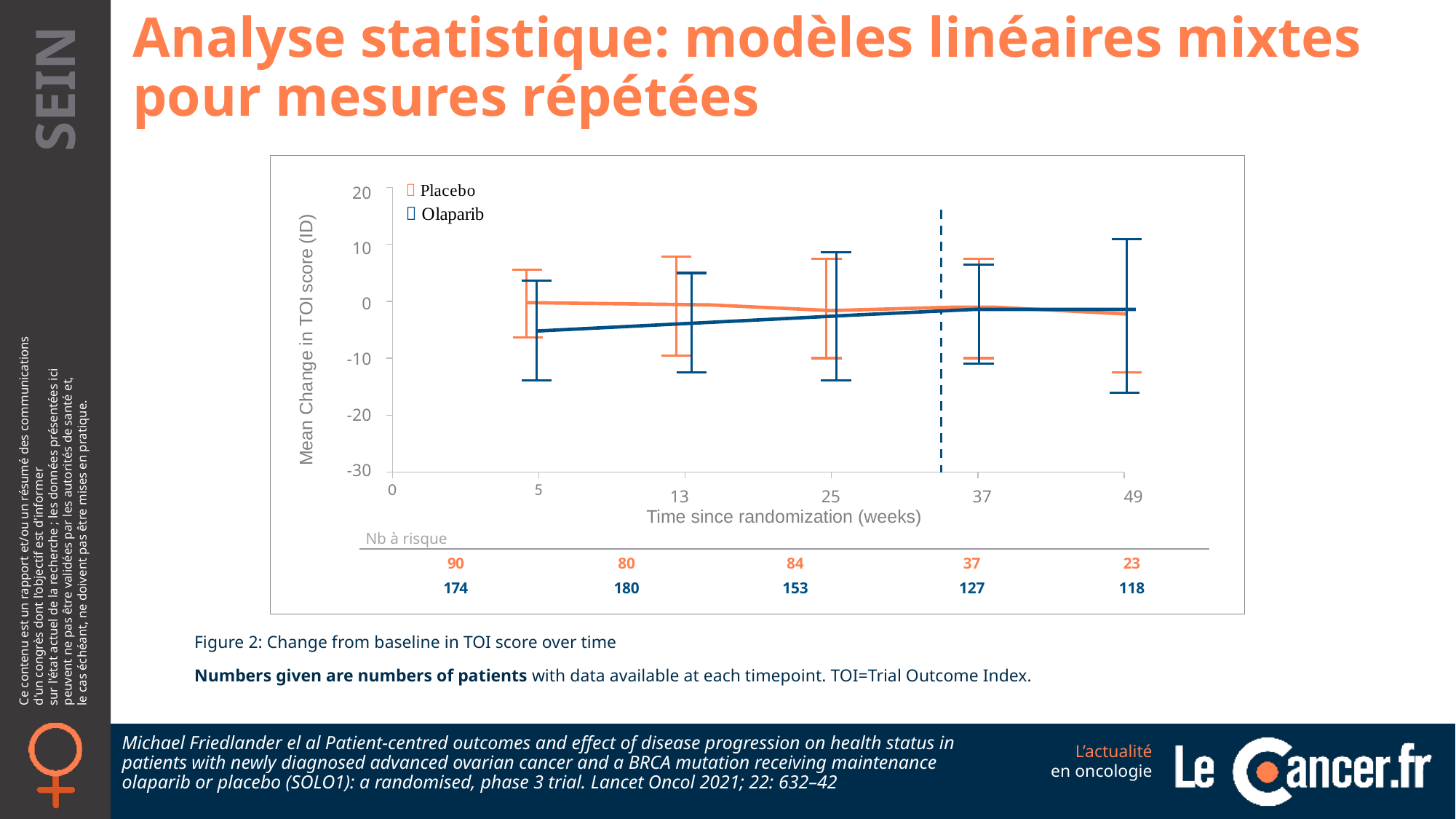
At which timepoint is the number of Placebo patients at risk lowest? 49 What is the label of the y axis? Mean Change in TOI score (ID) Does the Olaparib line rise or fall between week 5 and week 37? rise How many timepoints are plotted along the x axis? 5 Which series is drawn in orange? Placebo At which timepoint is the number of Olaparib patients at risk highest? 13 How many Placebo patients are at risk at week 49? 23 What kind of chart is shown on the slide? line chart How many Olaparib patients are at risk at week 5? 174 What is the difference between the number of Olaparib and Placebo patients at risk at week 25? 69 Is the mean change in TOI score for Olaparib at week 5 greater or less than 0? less How many series does the legend list? 2